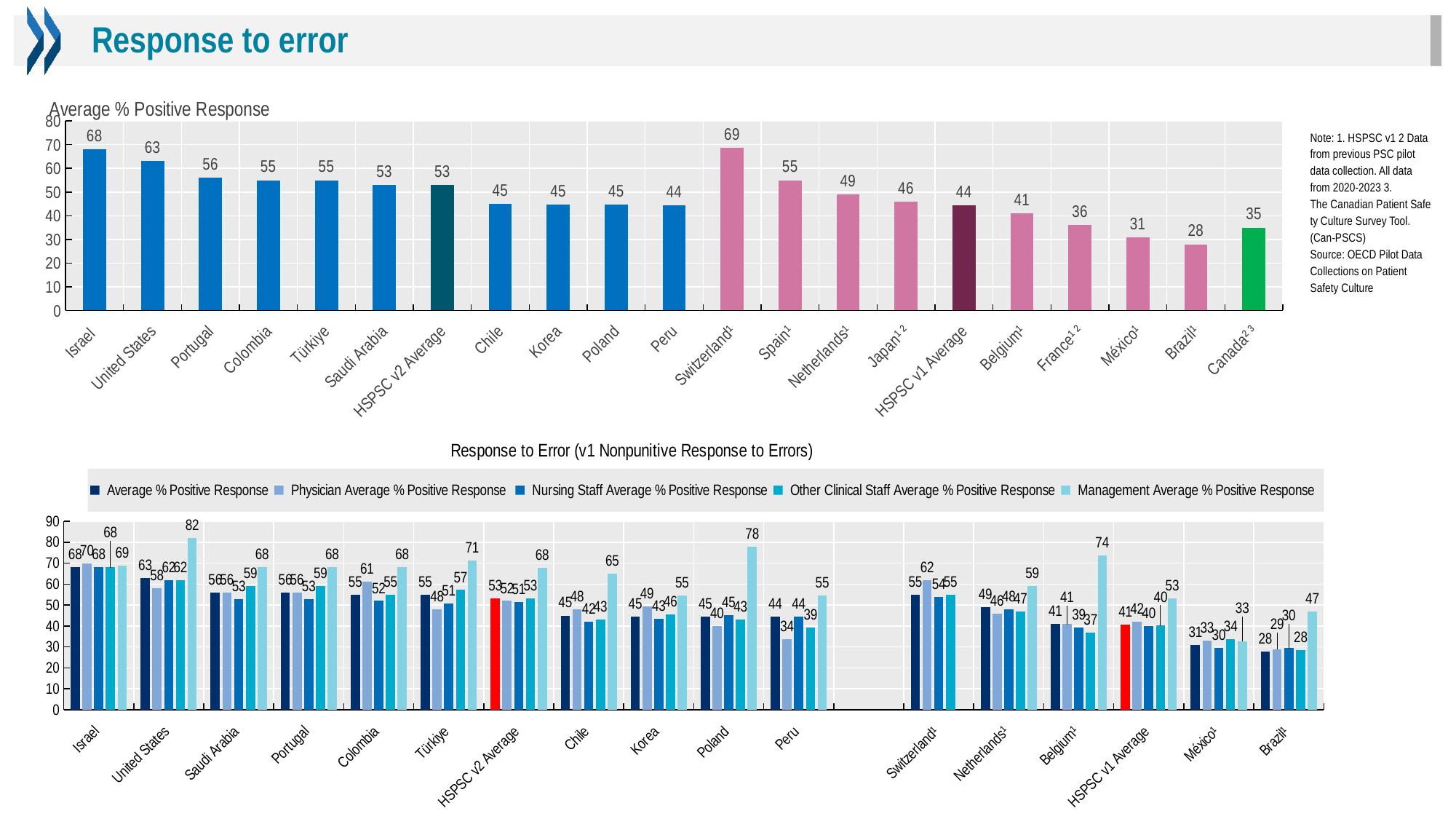
In the bottom chart (Response to Error), what is the Management Average % Positive Response for the United States? 82 In the bottom chart (Response to Error), how many series does the legend list? 5 In the bottom chart (Response to Error), what colour are the HSPSC v2 Average and HSPSC v1 Average bars for the Average % Positive Response series? Red In the top chart (Average % Positive Response), which country has the lowest value? Brazil In the bottom chart (Response to Error), what is the Physician Average % Positive Response for Peru? 34 In the top chart (Average % Positive Response), which is larger, the value for France or the value for Canada? France In the top chart (Average % Positive Response), which country has the highest value? Switzerland In the top chart (Average % Positive Response), what is the value for Israel? 68 What kind of chart is the top chart (Average % Positive Response)? Bar chart In the top chart (Average % Positive Response), how many bars are plotted? 21 In the top chart (Average % Positive Response), what is the difference between the HSPSC v2 Average and the HSPSC v1 Average? 9 In the bottom chart (Response to Error), which country has the highest Management Average % Positive Response? United States